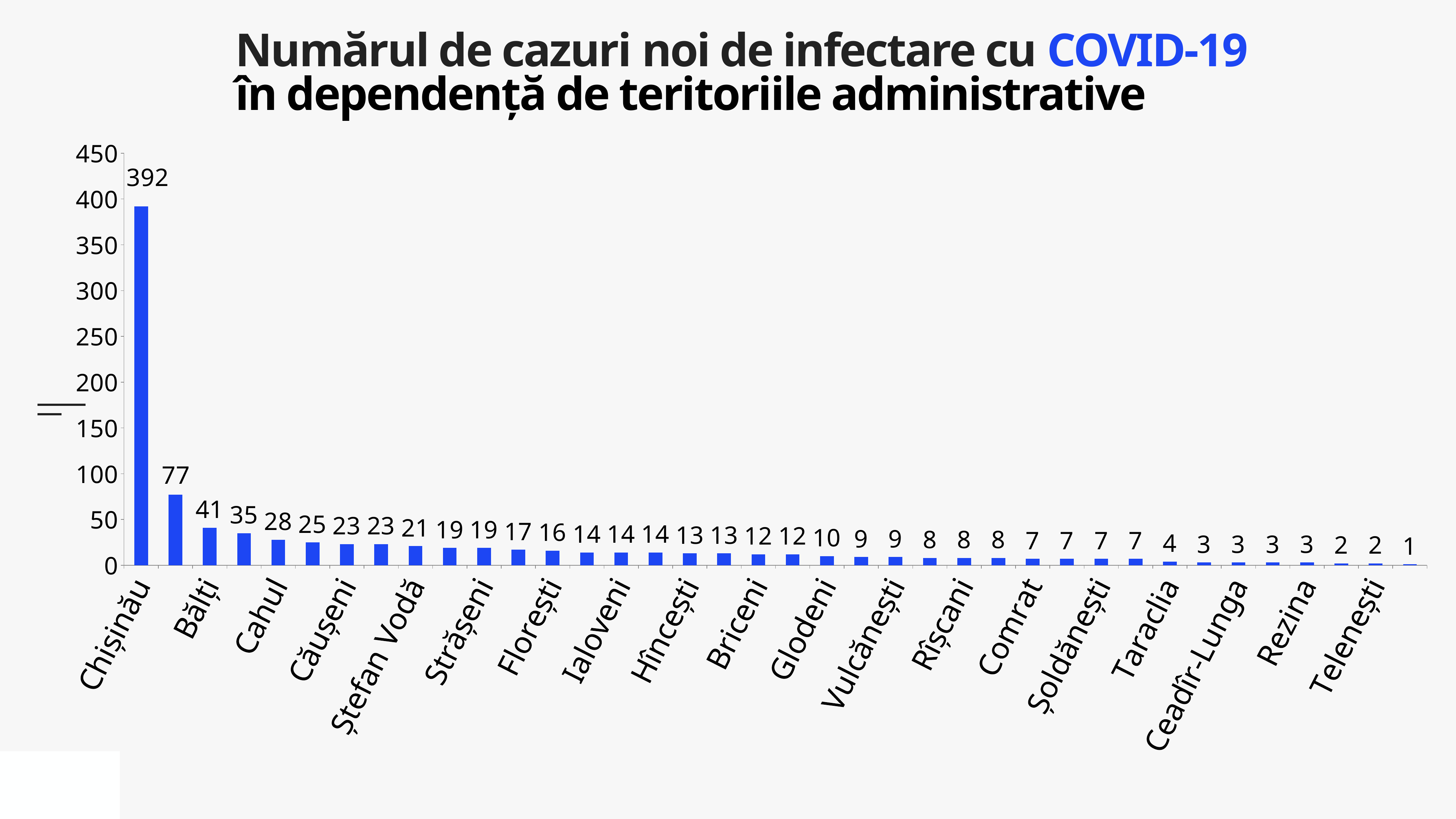
What is the second highest value shown on the chart? 77 Which territory has the highest number of new COVID-19 cases? Chișinău Is the value for Telenești greater or less than 50? less Do the values rise or fall from left to right along the x axis? fall What is the value for Chișinău? 392 Which is larger, the value for Chișinău or the value for Telenești? Chișinău What is the lowest value shown on the chart? 1 What is the difference between the highest value (392) and the second highest value (77)? 315 What is the highest tick value on the vertical axis? 450 Is the value for Chișinău greater or less than 350? greater What colour are the bars in the chart? blue What kind of chart is shown on the slide? bar chart